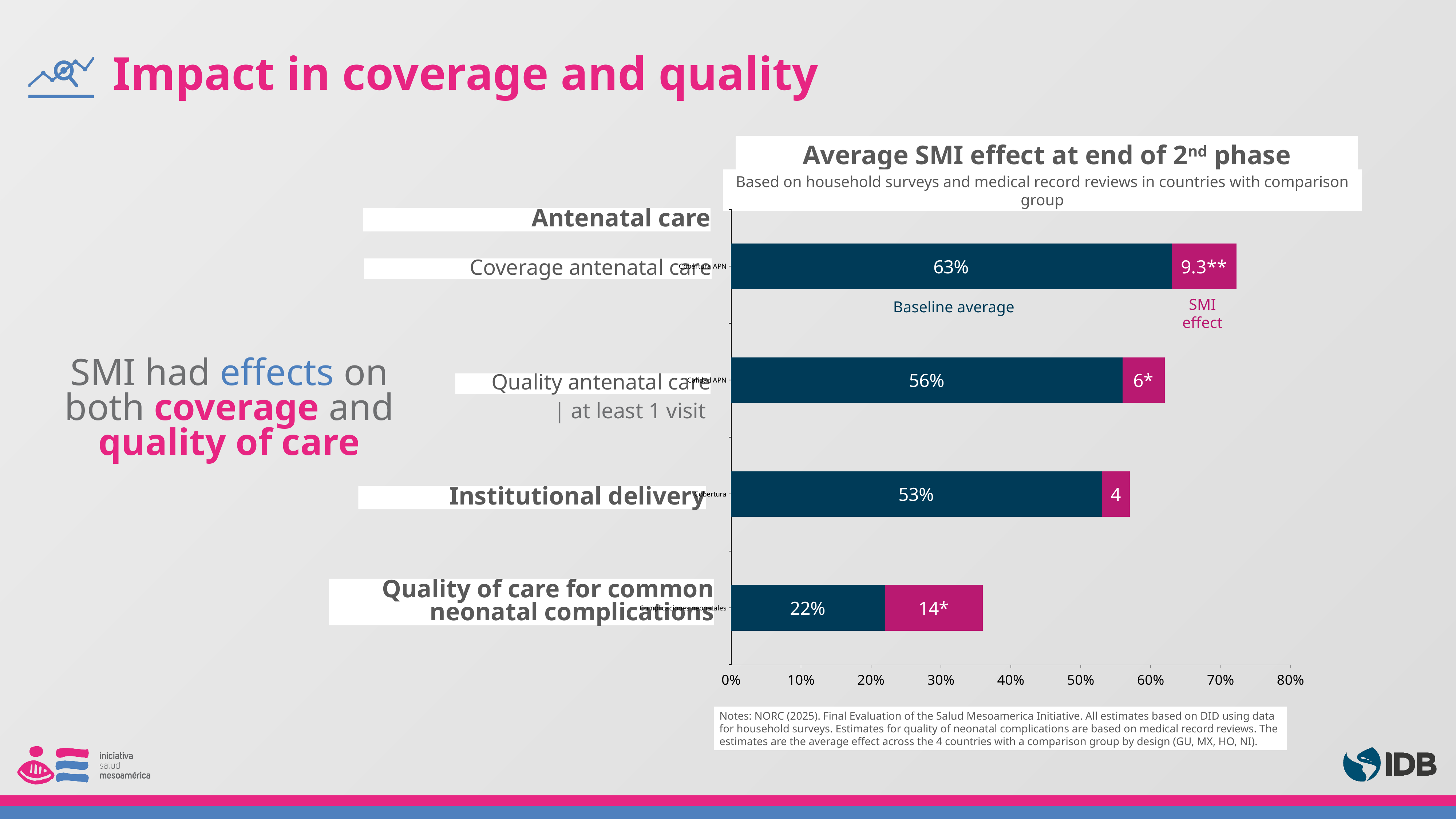
What is the baseline average for Coverage antenatal care? 63% Which category has the largest SMI effect? Quality of care for common neonatal complications What type of chart is shown on the slide? Bar chart Which category has the lowest baseline average? Quality of care for common neonatal complications What is the difference between the baseline averages for Coverage antenatal care and Quality antenatal care? 7% Which category has the highest baseline average? Coverage antenatal care Is the total bar length for Quality of care for common neonatal complications greater or less than 40%? less What is the baseline average for Institutional delivery? 53% How many categories are plotted in the chart? 4 What is the SMI effect shown for Coverage antenatal care? 9.3** What is the SMI effect shown for Quality of care for common neonatal complications? 14* Which has a larger baseline average, Quality antenatal care or Institutional delivery? Quality antenatal care